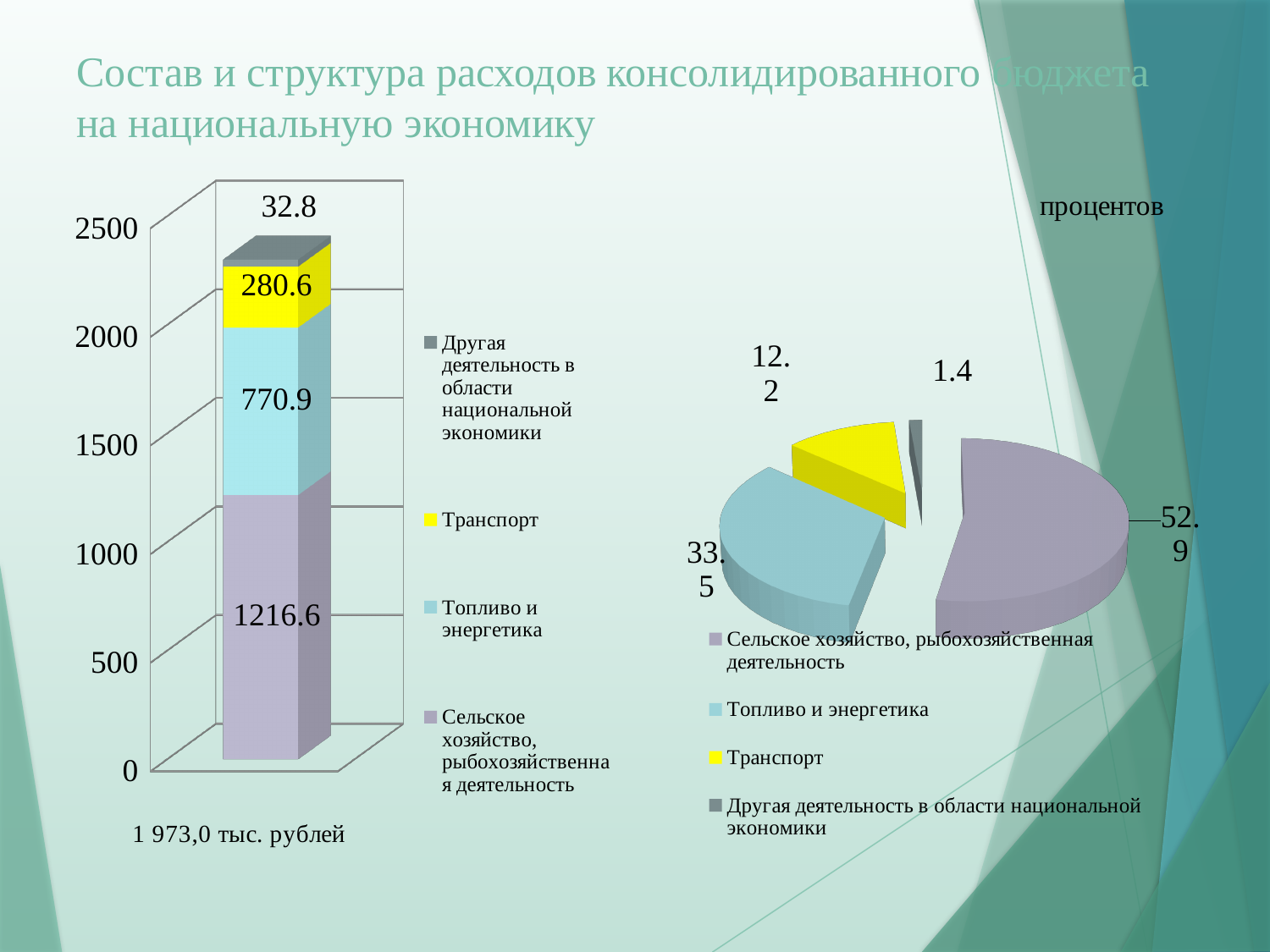
In the pie chart on the right, which slice is the largest? Сельское хозяйство, рыбохозяйственная деятельность In the bar chart on the left, what is the difference between the values for Сельское хозяйство, рыбохозяйственная деятельность and Топливо и энергетика? 445.7 In the bar chart on the left, what is the value for Топливо и энергетика? 770.9 In the pie chart on the right, which is larger: Топливо и энергетика or Транспорт? Топливо и энергетика What kind of chart is the chart on the left of the slide? bar chart In the bar chart on the left, what is the value for Транспорт? 280.6 In the pie chart on the right, how many slices are there? 4 What kind of chart is the chart on the right of the slide? pie chart In the pie chart on the right, what share does Сельское хозяйство, рыбохозяйственная деятельность have? 52.9 In the pie chart on the right, what is the value for Транспорт? 12.2 In the bar chart on the left, how many series does the legend list? 4 In the bar chart on the left, which segment has the smallest value? Другая деятельность в области национальной экономики